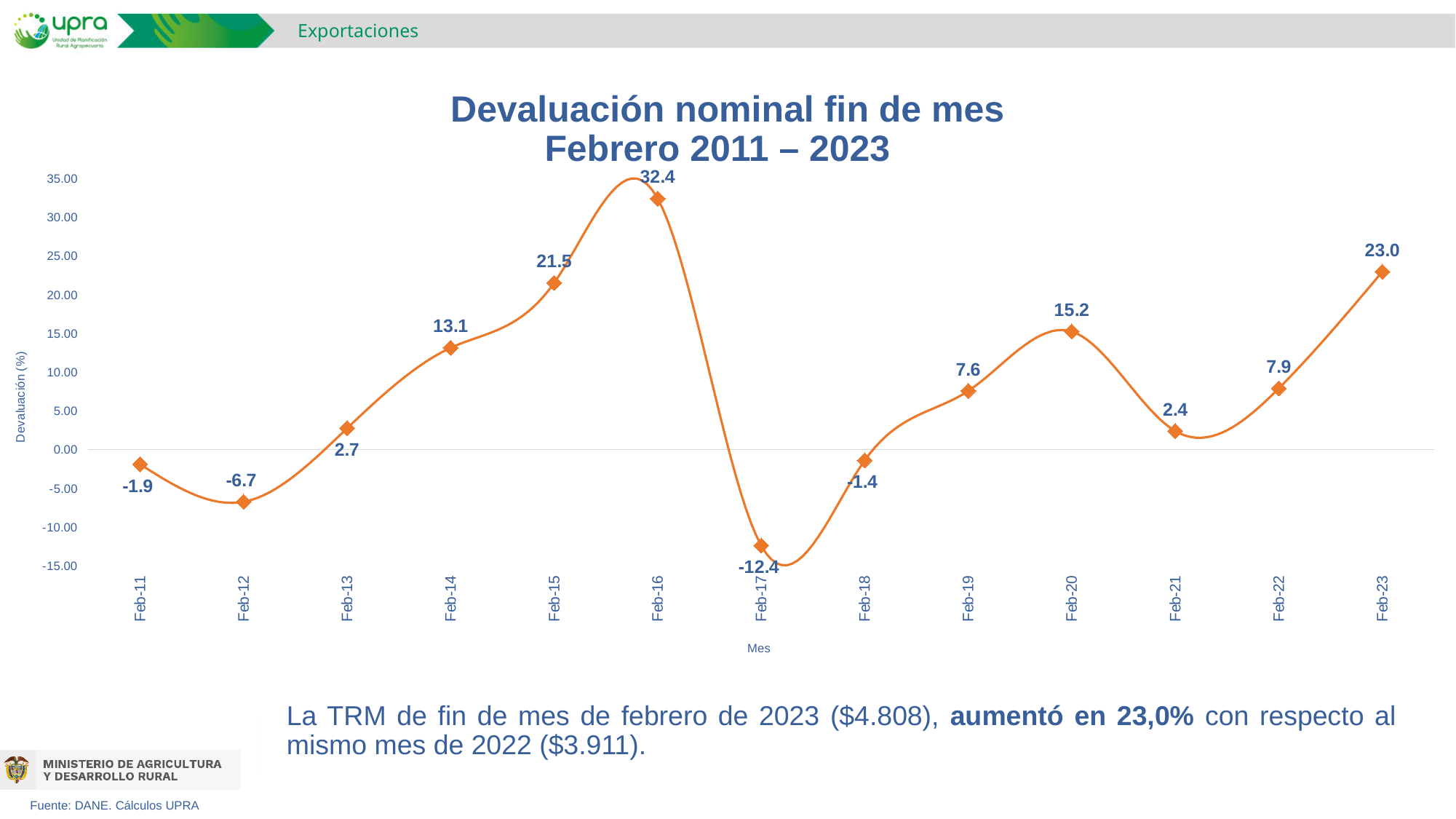
Is the value for Feb-14 greater or less than 10.00? greater How many data points are plotted on the chart? 13 What is the value for Feb-23? 23.0 What is the value for Feb-16? 32.4 What is the difference between the values for Feb-23 and Feb-22? 15.1 Do the values rise or fall from Feb-21 to Feb-23? rise What kind of chart is shown? line chart Which is larger, the value for Feb-15 or the value for Feb-20? Feb-15 What is the value for Feb-17? -12.4 Which month has the highest value? Feb-16 Which month has the lowest value? Feb-17 What is the title of the chart? Devaluación nominal fin de mes Febrero 2011 – 2023